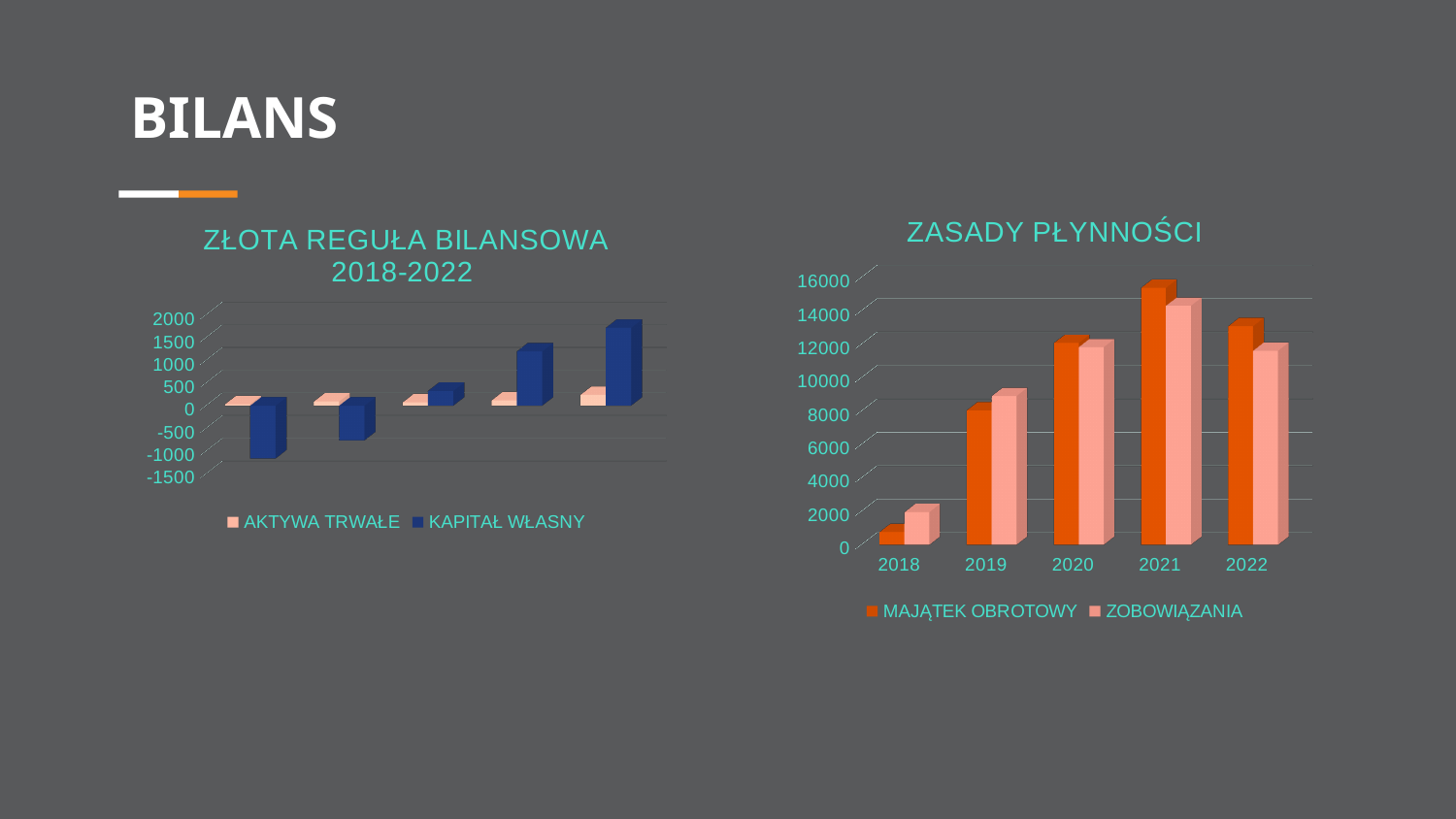
In the ZASADY PŁYNNOŚCI chart, which is larger in 2021: MAJĄTEK OBROTOWY or ZOBOWIĄZANIA? MAJĄTEK OBROTOWY How many series does the legend of the ZASADY PŁYNNOŚCI chart list? 2 In the ZASADY PŁYNNOŚCI chart, which is larger in 2019: MAJĄTEK OBROTOWY or ZOBOWIĄZANIA? ZOBOWIĄZANIA In the ZASADY PŁYNNOŚCI chart, which year has the lowest ZOBOWIĄZANIA value? 2018 What are the two legend entries of the ZŁOTA REGUŁA BILANSOWA 2018-2022 chart on the left? AKTYWA TRWAŁE and KAPITAŁ WŁASNY In the ZASADY PŁYNNOŚCI chart, which year has the highest MAJĄTEK OBROTOWY value? 2021 In the ZASADY PŁYNNOŚCI chart, is the MAJĄTEK OBROTOWY value for 2021 greater or less than 14000? greater In the ZASADY PŁYNNOŚCI chart, is the MAJĄTEK OBROTOWY value for 2018 greater or less than 2000? less What kind of chart is the ZASADY PŁYNNOŚCI chart on the right? bar chart In the ZASADY PŁYNNOŚCI chart, does MAJĄTEK OBROTOWY rise or fall from 2018 to 2021? rise How many years are shown on the x axis of the ZASADY PŁYNNOŚCI chart? 5 In the ZŁOTA REGUŁA BILANSOWA 2018-2022 chart, is the KAPITAŁ WŁASNY value for the first group greater or less than 0? less